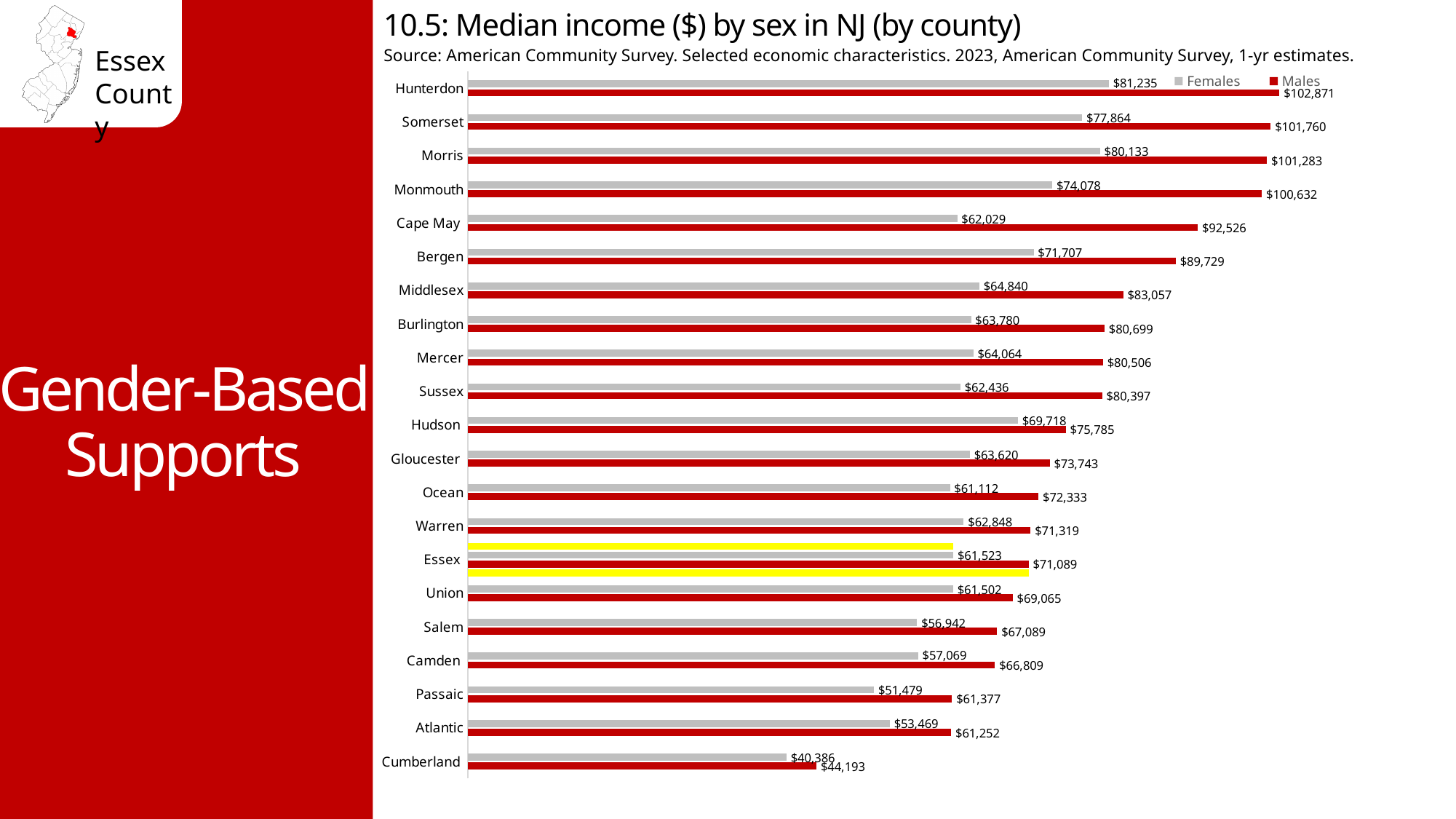
What is the difference between male and female median income in Hunterdon County? $21,636 What is the median income for females in Hunterdon County? $81,235 What is the median income for females in Essex County? $61,523 What is the median income for males in Essex County? $71,089 What is the median income for males in Cumberland County? $44,193 Which county has the highest median income for males? Hunterdon What is the difference between male and female median income in Essex County? $9,566 Which is larger, the female median income in Hudson County or in Bergen County? Bergen County How many counties are shown in the chart? 21 How many series does the legend list? 2 Which county has the lowest median income for females? Cumberland What type of chart is used to show median income by sex? Bar chart